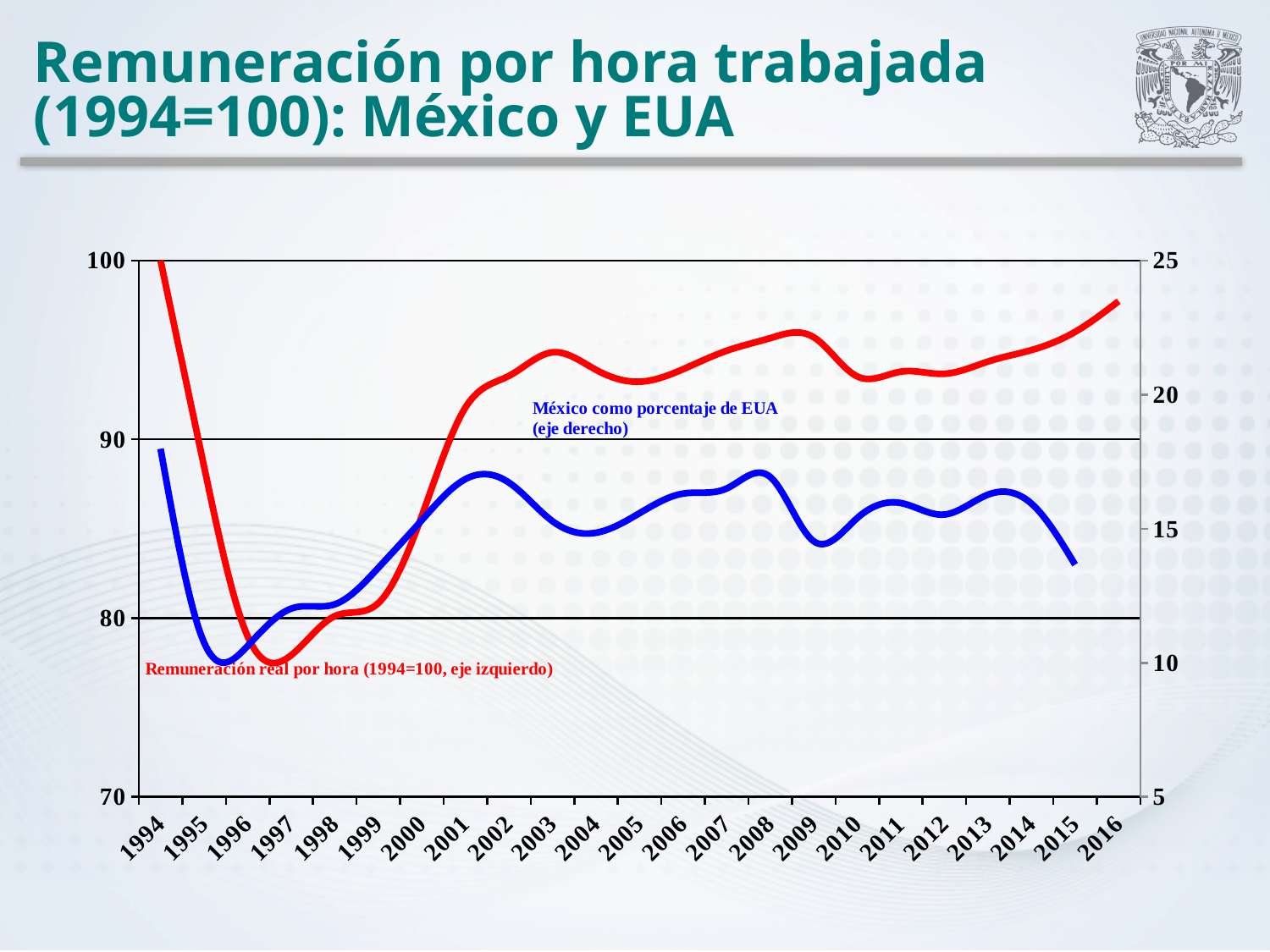
In which year does the red line (Remuneración real por hora) reach its highest value? 1994 Does the red line (Remuneración real por hora) rise or fall between 2010 and 2016? rise How many years are labelled on the x axis of the chart? 23 What is the value of the red line (Remuneración real por hora) in 1994? 100 Is the value of the red line (Remuneración real por hora) in 1997 greater or less than 80? less What kind of chart is shown on the slide? line chart Which axis does the blue line (México como porcentaje de EUA) use? the right axis (eje derecho) Is the value of the red line (Remuneración real por hora) in 2016 greater or less than 90? greater Is the value of the blue line (México como porcentaje de EUA) in 2015 greater or less than 15 on the right axis? less Which is higher for the blue line (México como porcentaje de EUA): the value in 2008 or in 2009? 2008 How many data series are plotted on the chart? 2